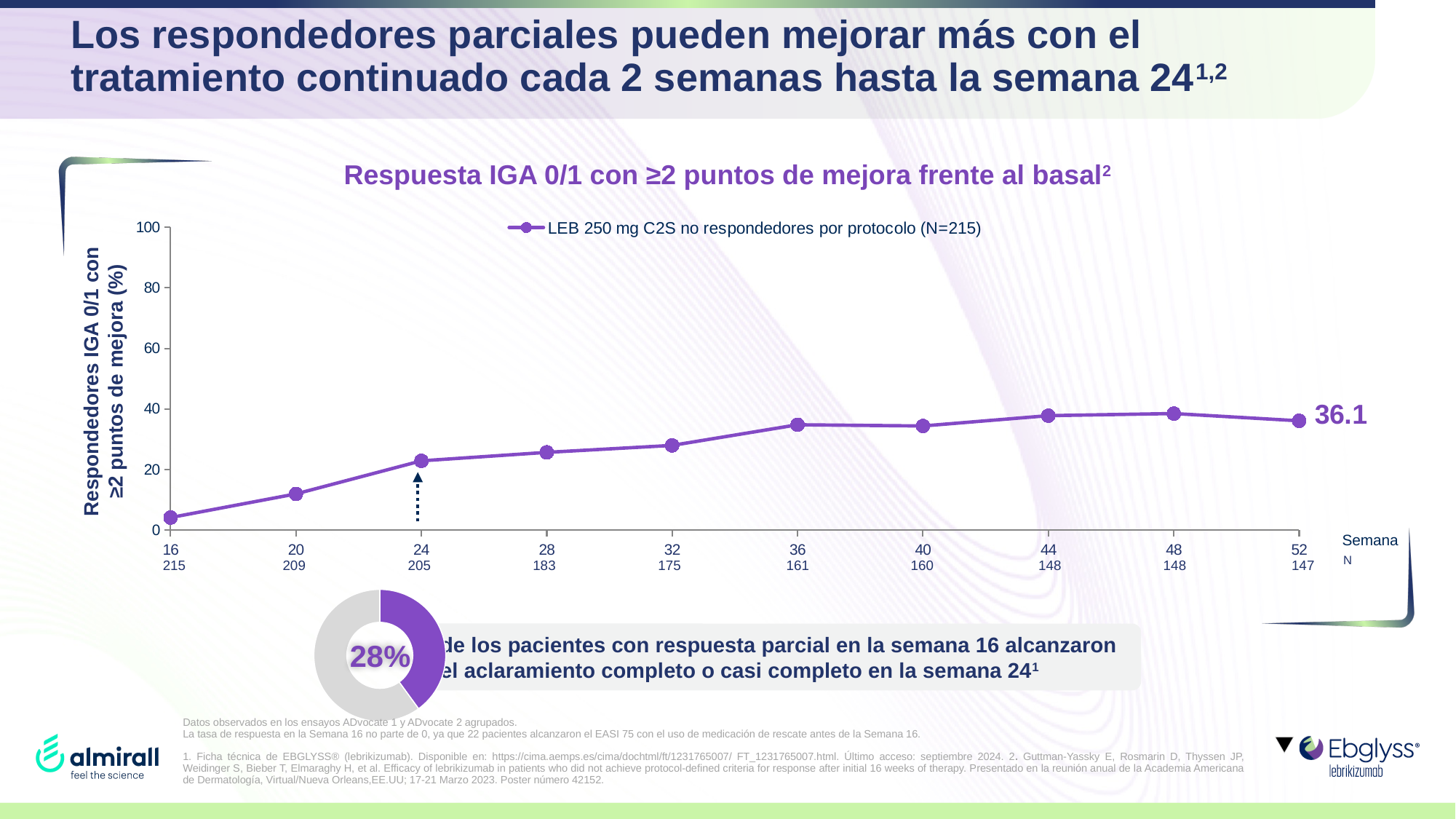
What is the legend entry of the series in the line chart? LEB 250 mg C2S no respondedores por protocolo (N=215) How many series does the legend of the line chart list? 1 In the line chart, is the value at week 16 greater or less than 20? less In the line chart, what is the N shown under week 52? 147 How many data points are plotted on the line chart? 10 In the line chart, what is the value at week 52? 36.1 In the line chart, which is larger: the value at week 20 or the value at week 36? Week 36 What percentage does the doughnut chart at the bottom of the slide show? 28% In the line chart, do the values generally rise or fall from week 16 to week 52? Rise In the line chart, at which week is the value lowest? 16 What type of chart is used for 'Respuesta IGA 0/1 con ≥2 puntos de mejora frente al basal'? Line chart In the line chart, is the value at week 36 greater or less than 20? greater